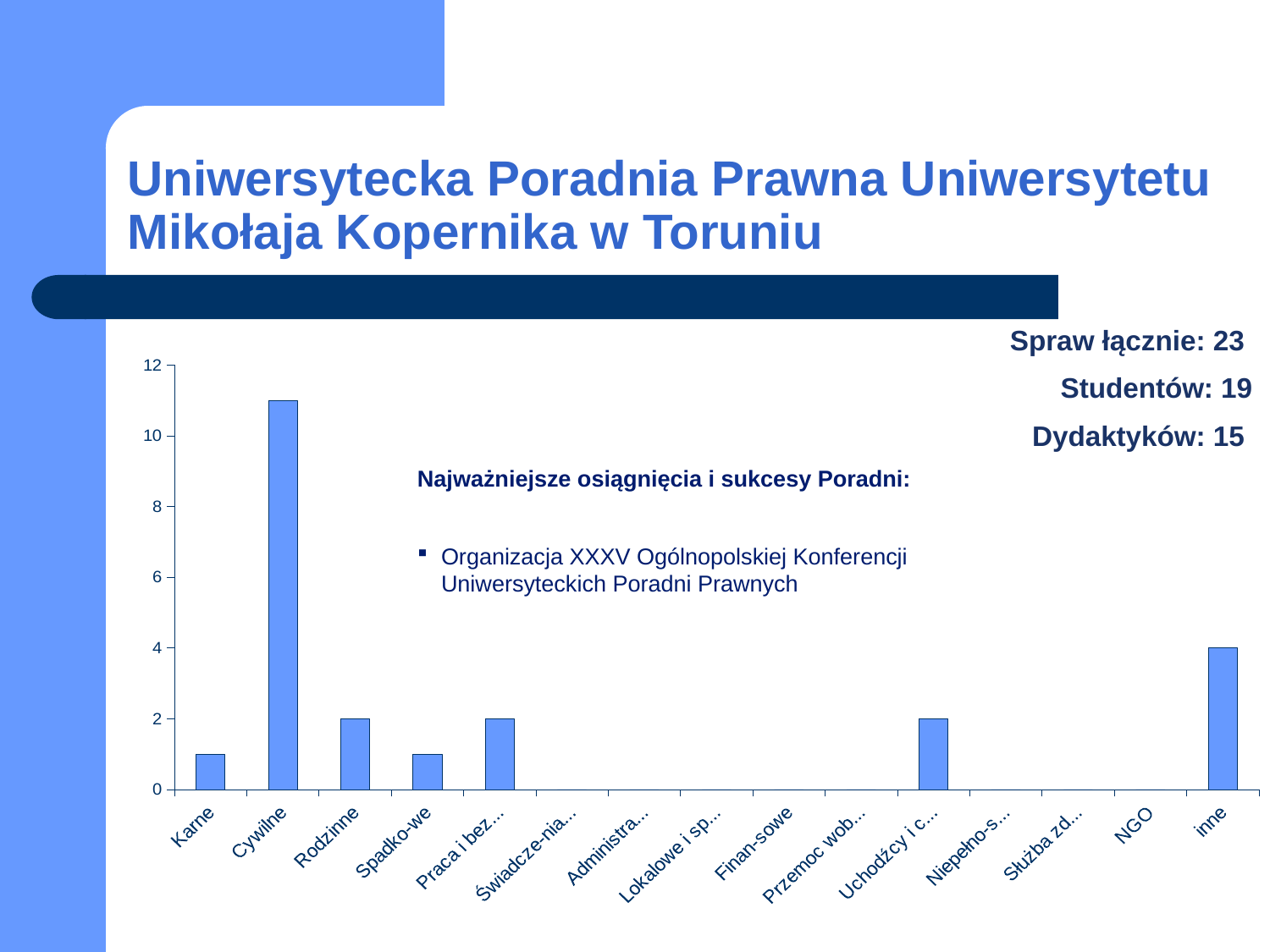
Which category has the highest bar in the chart? Cywilne Is the value for Karne greater or less than 2? less What is the value for Uchodźcy i c... in the chart? 2 What is the difference between the value for inne and the value for Rodzinne? 2 What is the highest value shown on the y axis of the chart? 12 How many categories are shown on the x axis of the chart? 15 Which is larger, the value for Cywilne or the value for inne? Cywilne What is the value for inne in the chart? 4 Is the value for Cywilne greater or less than 10? greater What is the value for Rodzinne in the chart? 2 What kind of chart is shown on the slide? bar chart Is the value for Spadko-we greater or less than 2? less